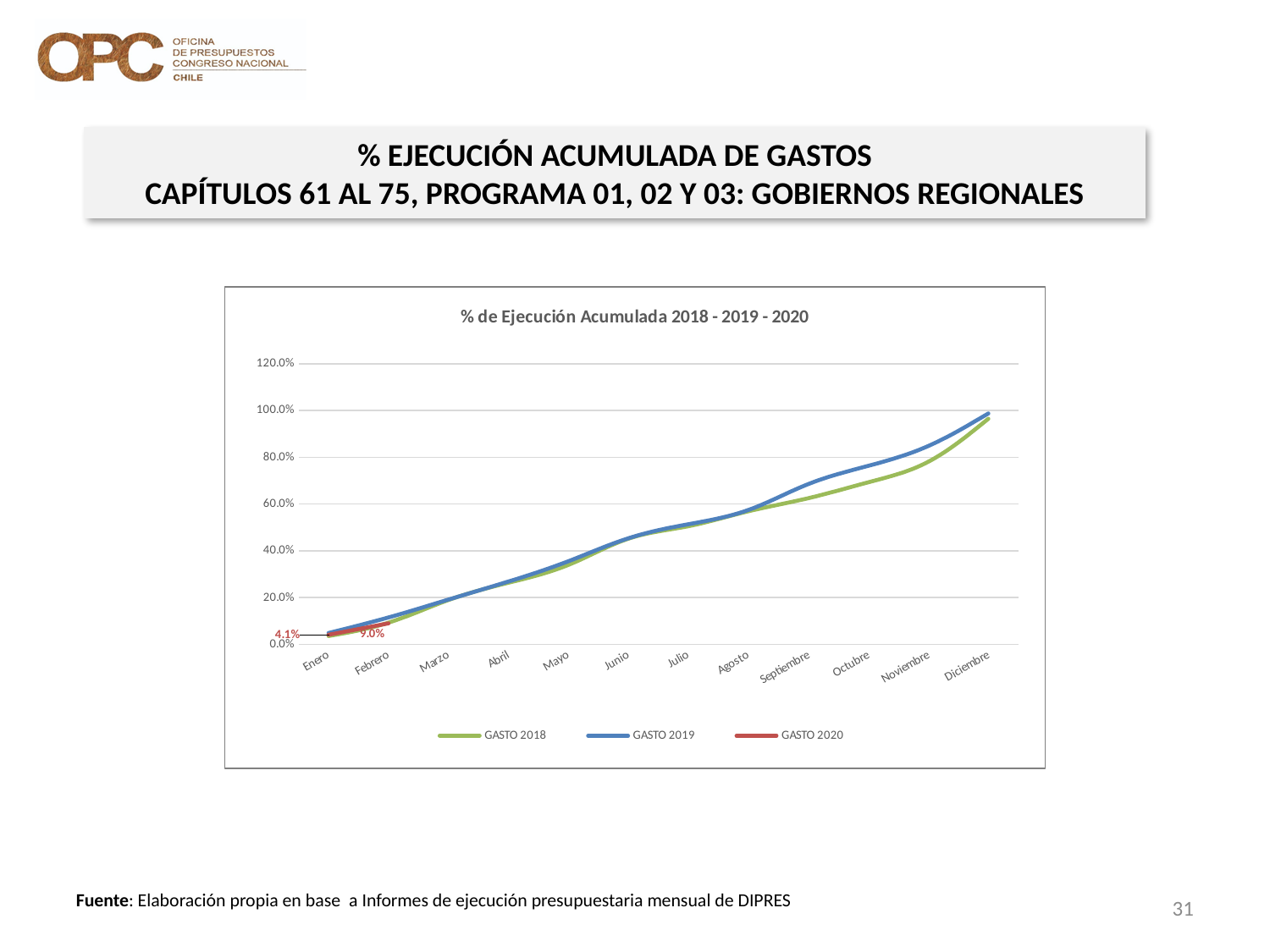
How many series does the legend list? 3 Which month has the larger GASTO 2020 value, Enero or Febrero? Febrero What is the value of GASTO 2020 in Enero? 4.1% How many months are shown on the x axis? 12 Is the value for GASTO 2019 in Diciembre greater or less than 80.0%? greater Is the value for GASTO 2018 in Junio greater or less than 60.0%? less Do the GASTO 2019 values rise or fall from Enero to Diciembre? Rise Which series has the larger value in Noviembre, GASTO 2018 or GASTO 2019? GASTO 2019 Is the value for GASTO 2019 in Septiembre greater or less than 60.0%? greater What kind of chart is shown? Line chart What is the difference between the GASTO 2020 values for Febrero and Enero? 4.9% What is the value of GASTO 2020 in Febrero? 9.0%